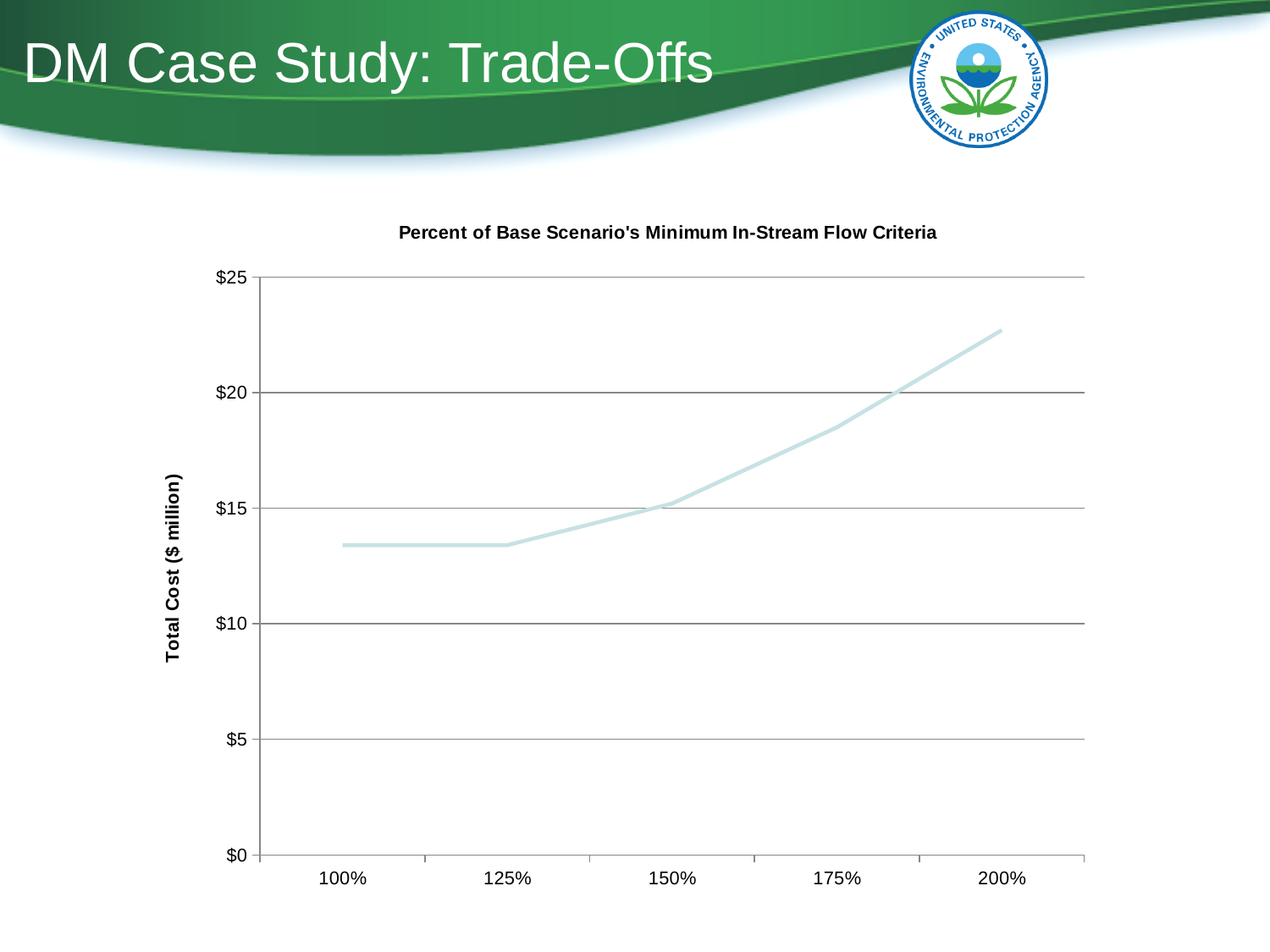
Is the total cost at 175% greater or less than $15 million? greater At which percentage of the base scenario's minimum in-stream flow criteria is the total cost highest? 200% Does the total cost rise or fall as the percentage of the base scenario's minimum in-stream flow criteria increases from 100% to 200%? rise What is the label on the vertical axis of the chart? Total Cost ($ million) Is the total cost at 125% greater or less than $10 million? greater Is the total cost at 200% greater or less than $20 million? greater Which has a higher total cost, 150% or 175%? 175% How many data points are plotted on the line? 5 What kind of chart is shown on the slide? line chart What is the title of the chart? Percent of Base Scenario's Minimum In-Stream Flow Criteria